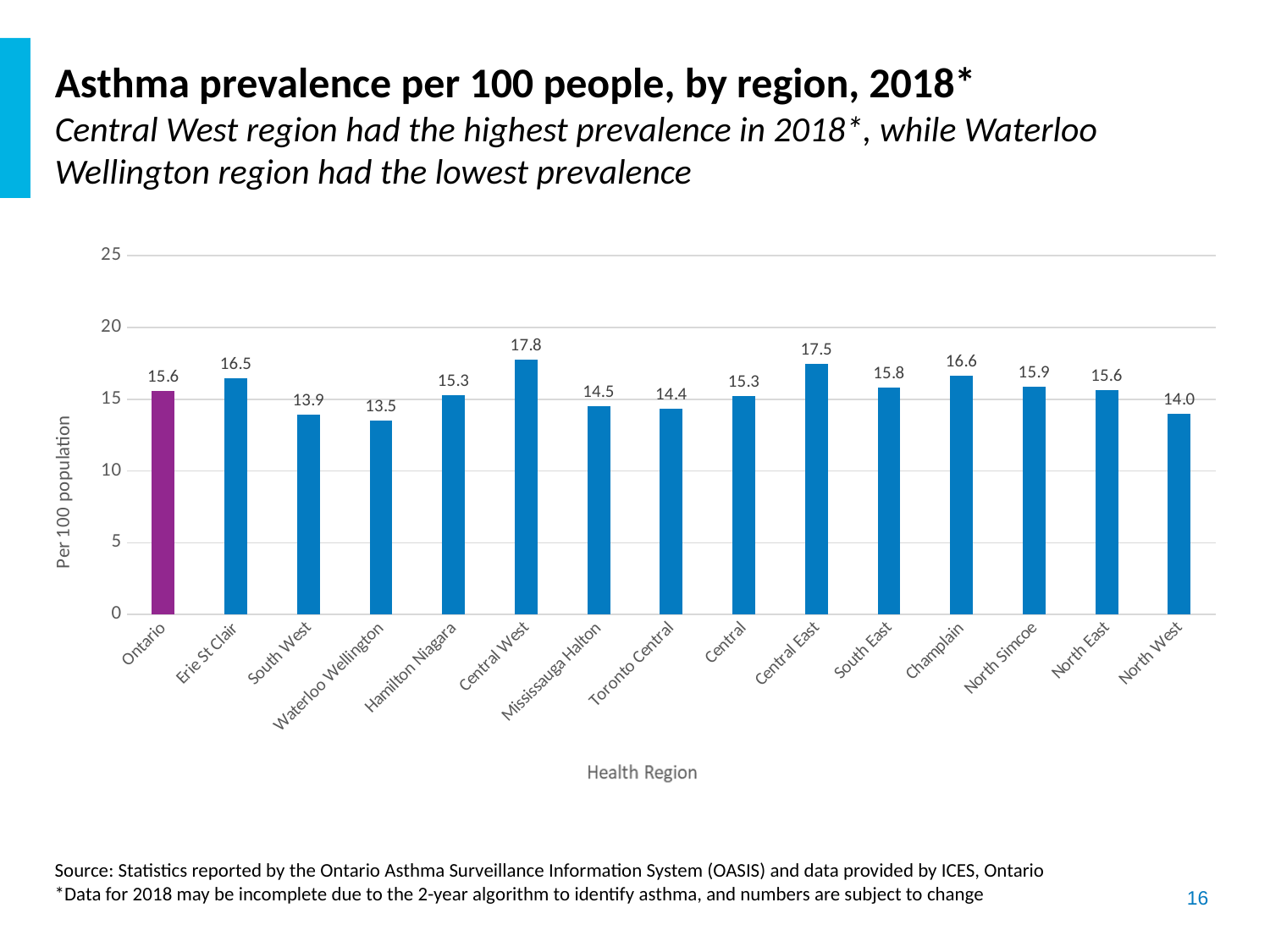
What type of chart is shown on the slide? bar chart What is the asthma prevalence per 100 people for Central West? 17.8 How many health regions (including Ontario) are shown on the x axis? 15 Is the asthma prevalence per 100 people for North West greater or less than 15? less What is the difference in asthma prevalence per 100 people between Central West and Waterloo Wellington? 4.3 Which health region has the lowest asthma prevalence per 100 people? Waterloo Wellington What is the asthma prevalence per 100 people for Champlain? 16.6 What is the asthma prevalence per 100 people for Ontario? 15.6 Which health region has the highest asthma prevalence per 100 people? Central West Which has a higher asthma prevalence per 100 people, Central East or Champlain? Central East Which bar is shown in a different colour (purple) from the others? Ontario What is the difference in asthma prevalence per 100 people between Erie St Clair and South West? 2.6